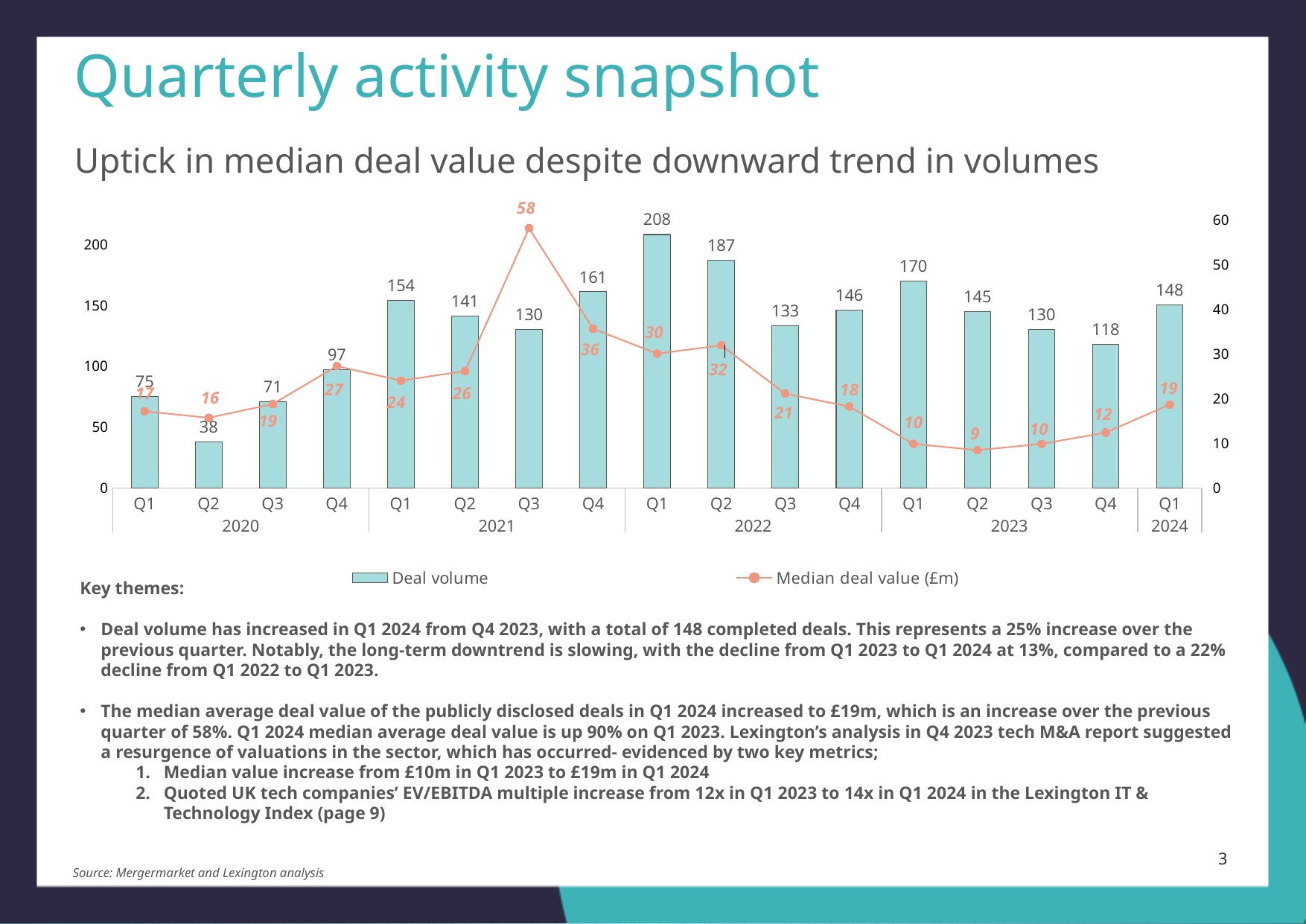
What is the deal volume for Q1 2024? 148 Which quarter has the lowest deal volume? Q2 2020 What kind of chart is used to show deal volume? Bar chart What is the median deal value (£m) for Q3 2021? 58 Which quarter has the lowest median deal value (£m)? Q2 2023 Which quarter has the highest deal volume? Q1 2022 How many quarters are shown on the x axis? 17 What is the difference in median deal value (£m) between Q1 2024 and Q1 2023? 9 What is the difference in deal volume between Q1 2024 and Q4 2023? 30 Does the median deal value rise or fall from Q2 2023 to Q1 2024? Rise Which quarter has the larger deal volume, Q1 2021 or Q1 2023? Q1 2023 How many series does the legend list? 2